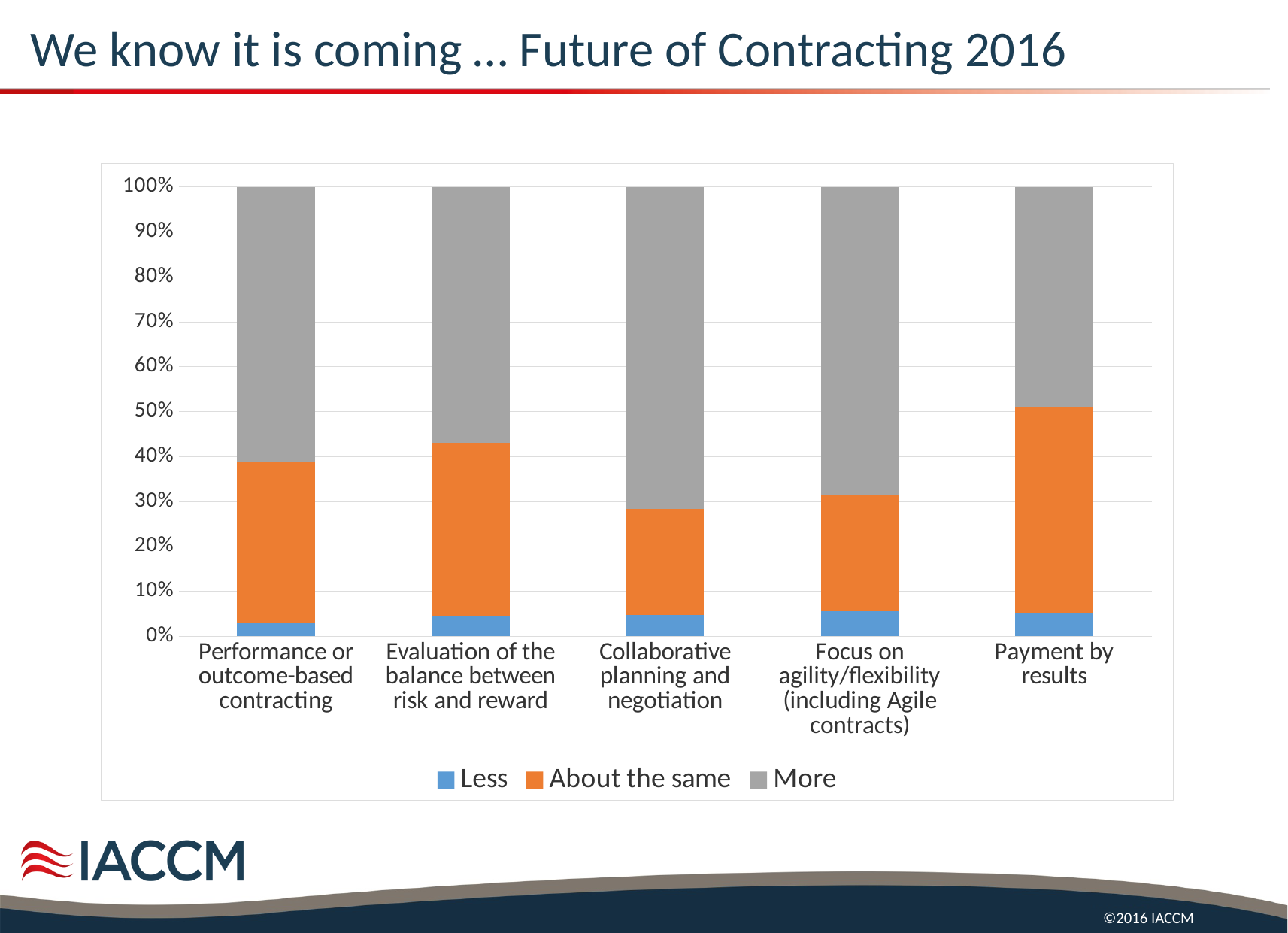
Which category has the smallest 'More' share? Payment by results Which category has the largest 'About the same' share? Payment by results Which category has the largest 'More' share? Collaborative planning and negotiation How many series does the chart's legend list? 3 Is the 'More' share for Collaborative planning and negotiation greater or less than 60%? greater Is the 'Less' share for Focus on agility/flexibility (including Agile contracts) greater or less than 10%? less Is the 'More' share for Evaluation of the balance between risk and reward greater or less than 50%? greater What are the three series listed in the chart's legend? Less, About the same, More What kind of chart is shown on the slide? Stacked bar chart How many categories are shown along the x axis of the chart? 5 What is the total height of the stacked bar for Payment by results? 100% Which is larger: the 'More' share for Collaborative planning and negotiation or for Payment by results? Collaborative planning and negotiation